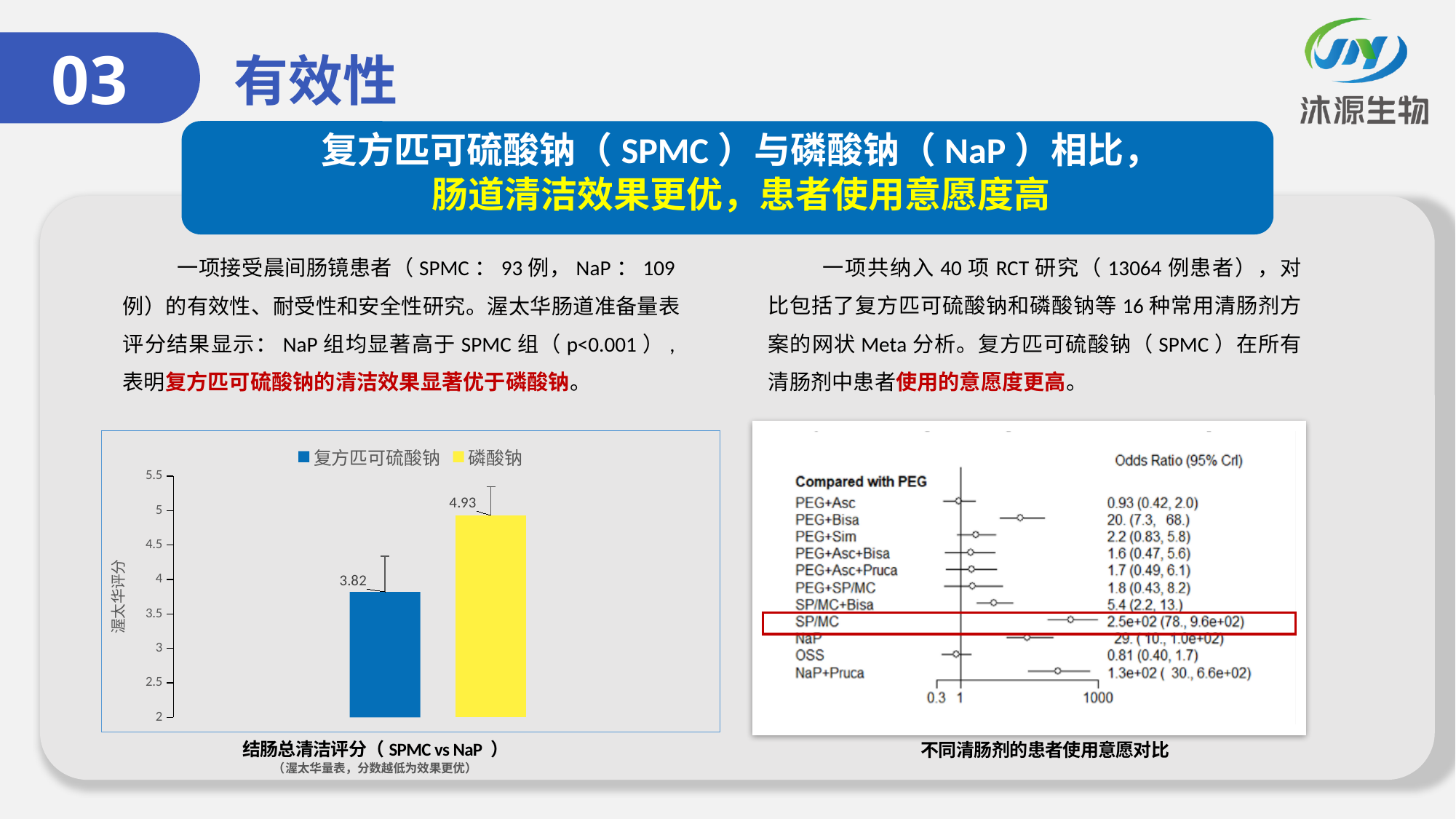
In the bar chart titled 结肠总清洁评分（SPMC vs NaP）, what is the value for 磷酸钠? 4.93 In the bar chart titled 结肠总清洁评分（SPMC vs NaP）, is the value for 复方匹可硫酸钠 greater or less than 4? less In the chart on the right titled 不同清肠剂的患者使用意愿对比, what is the Odds Ratio (95% CrI) shown for OSS? 0.81 (0.40, 1.7) In the bar chart titled 结肠总清洁评分（SPMC vs NaP）, how many series does the legend list? 2 In the chart on the right titled 不同清肠剂的患者使用意愿对比, how many regimens are listed under Compared with PEG? 11 In the bar chart titled 结肠总清洁评分（SPMC vs NaP）, what is the difference between the 磷酸钠 value and the 复方匹可硫酸钠 value? 1.11 In the bar chart titled 结肠总清洁评分（SPMC vs NaP）, what is the label on the vertical axis? 渥太华评分 In the bar chart titled 结肠总清洁评分（SPMC vs NaP）, which series has the higher value? 磷酸钠 In the chart on the right titled 不同清肠剂的患者使用意愿对比, which regimen has the highest odds ratio compared with PEG? SP/MC In the chart on the right titled 不同清肠剂的患者使用意愿对比, what is the Odds Ratio (95% CrI) shown for SP/MC? 2.5e+02 (78., 9.6e+02) What kind of chart is the one on the left of the slide, titled 结肠总清洁评分（SPMC vs NaP）? bar chart In the bar chart titled 结肠总清洁评分（SPMC vs NaP）, what is the value for 复方匹可硫酸钠? 3.82